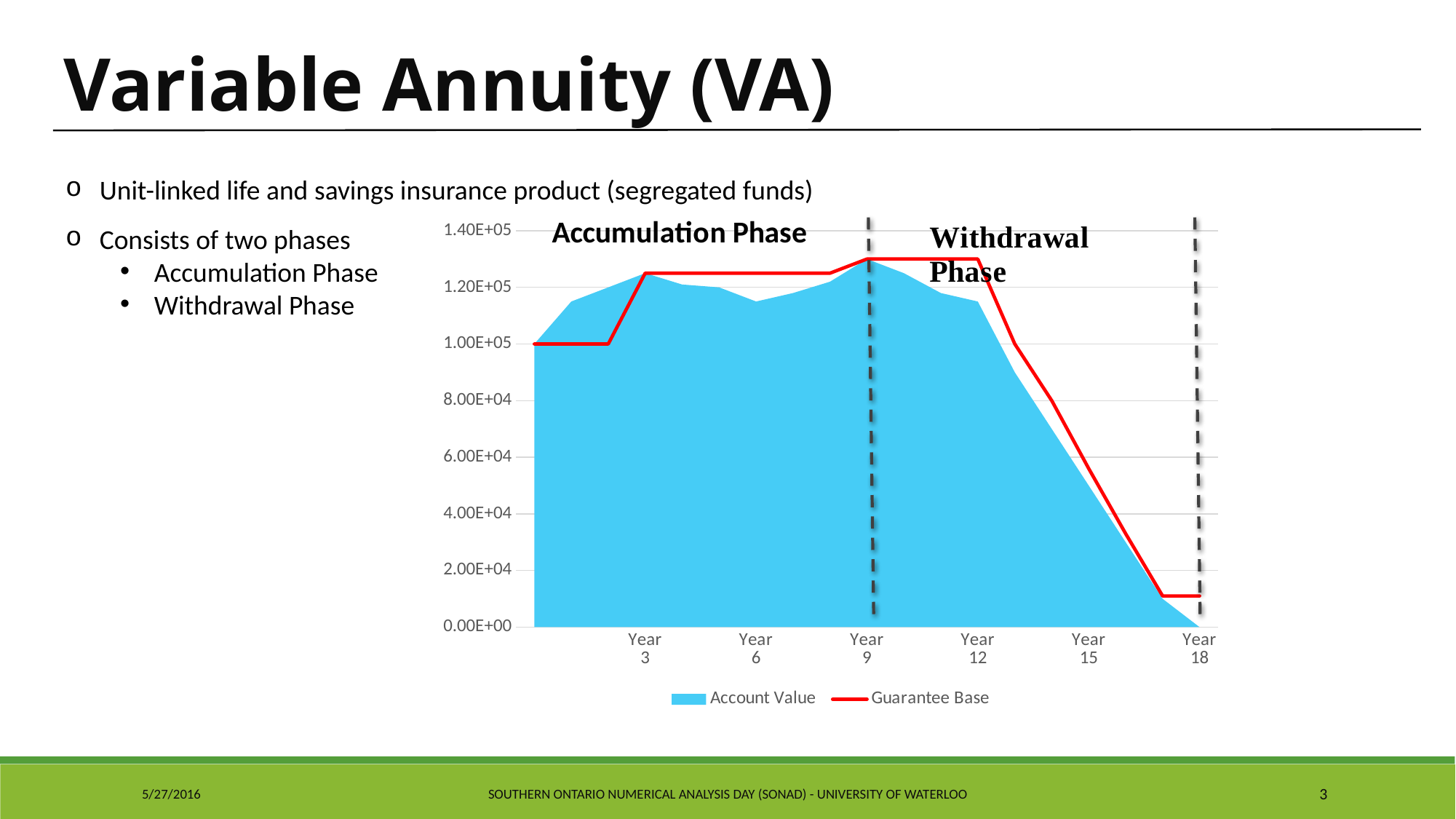
At Year 15, which is larger: the Account Value or the Guarantee Base? Guarantee Base What is the value of the Guarantee Base at the start of the chart (the leftmost point)? 1.00E+05 Is the Account Value at Year 15 greater or less than 8.00E+04? less Is the Guarantee Base at Year 9 greater or less than 1.20E+05? greater Is the Guarantee Base at Year 18 greater or less than 2.00E+04? less What are the two series named in the chart legend? Account Value and Guarantee Base How many series does the chart legend list? 2 What kind of chart is shown on the slide? Area chart with a line series Which phase label appears on the left side of the chart, before the first dashed vertical line? Accumulation Phase How many year labels are shown on the x axis of the chart? 6 Does the Account Value rise or fall from Year 12 to Year 18? fall